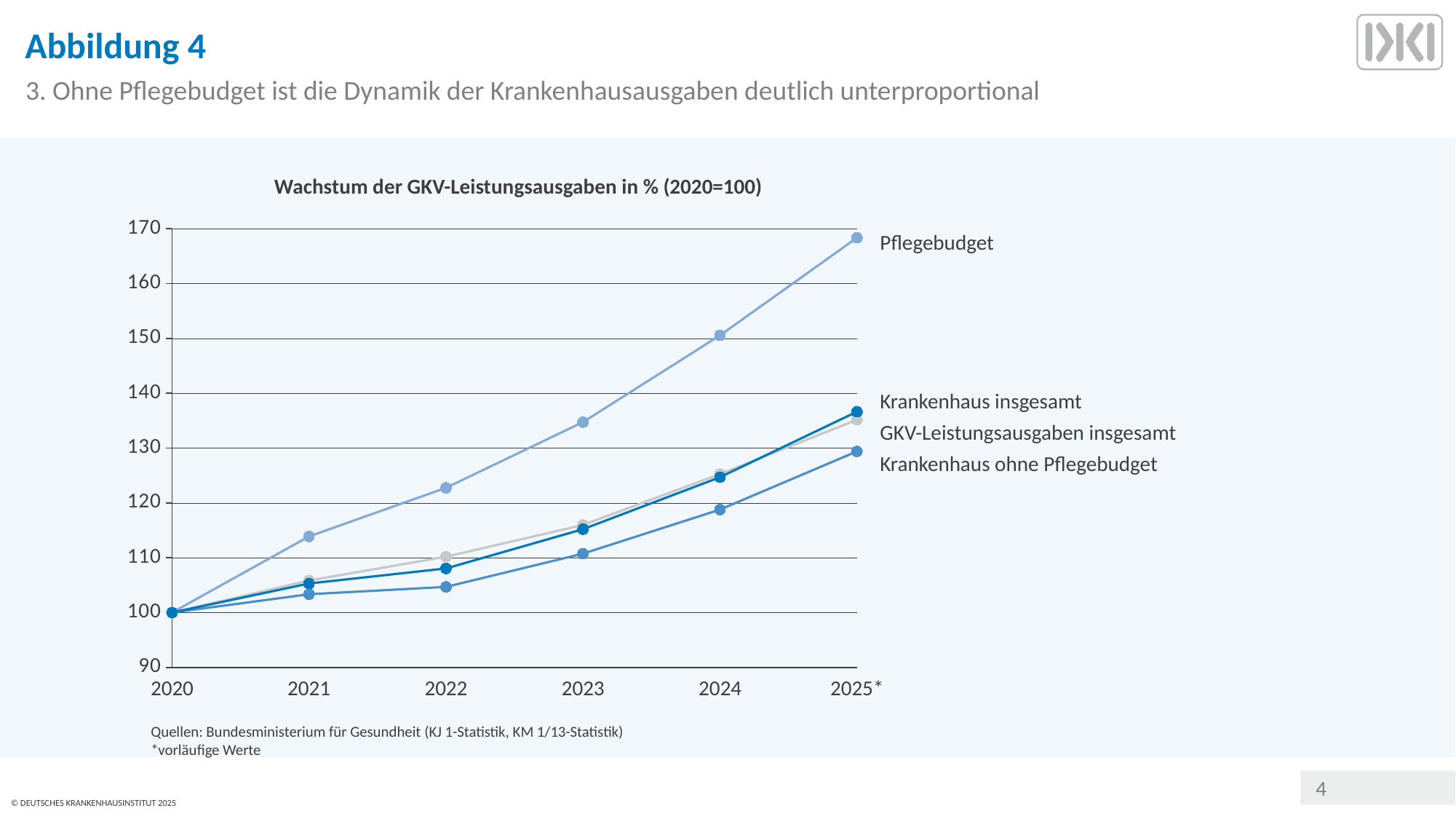
What is the title of the chart? Wachstum der GKV-Leistungsausgaben in % (2020=100) Is the value for Pflegebudget in 2023 greater or less than 130? greater Which series has the highest value in 2025*? Pflegebudget How many years are shown on the x axis of the chart? 6 How many series are plotted in the chart? 4 Is the value for Krankenhaus ohne Pflegebudget in 2024 greater or less than 120? less In 2024, which is larger: Pflegebudget or Krankenhaus ohne Pflegebudget? Pflegebudget What is the value of all series in 2020? 100 Does the Pflegebudget series rise or fall from 2020 to 2025*? rise Which series has the lowest value in 2025*? Krankenhaus ohne Pflegebudget Is the value for Pflegebudget in 2025* greater or less than 160? greater What kind of chart is shown on the slide? line chart